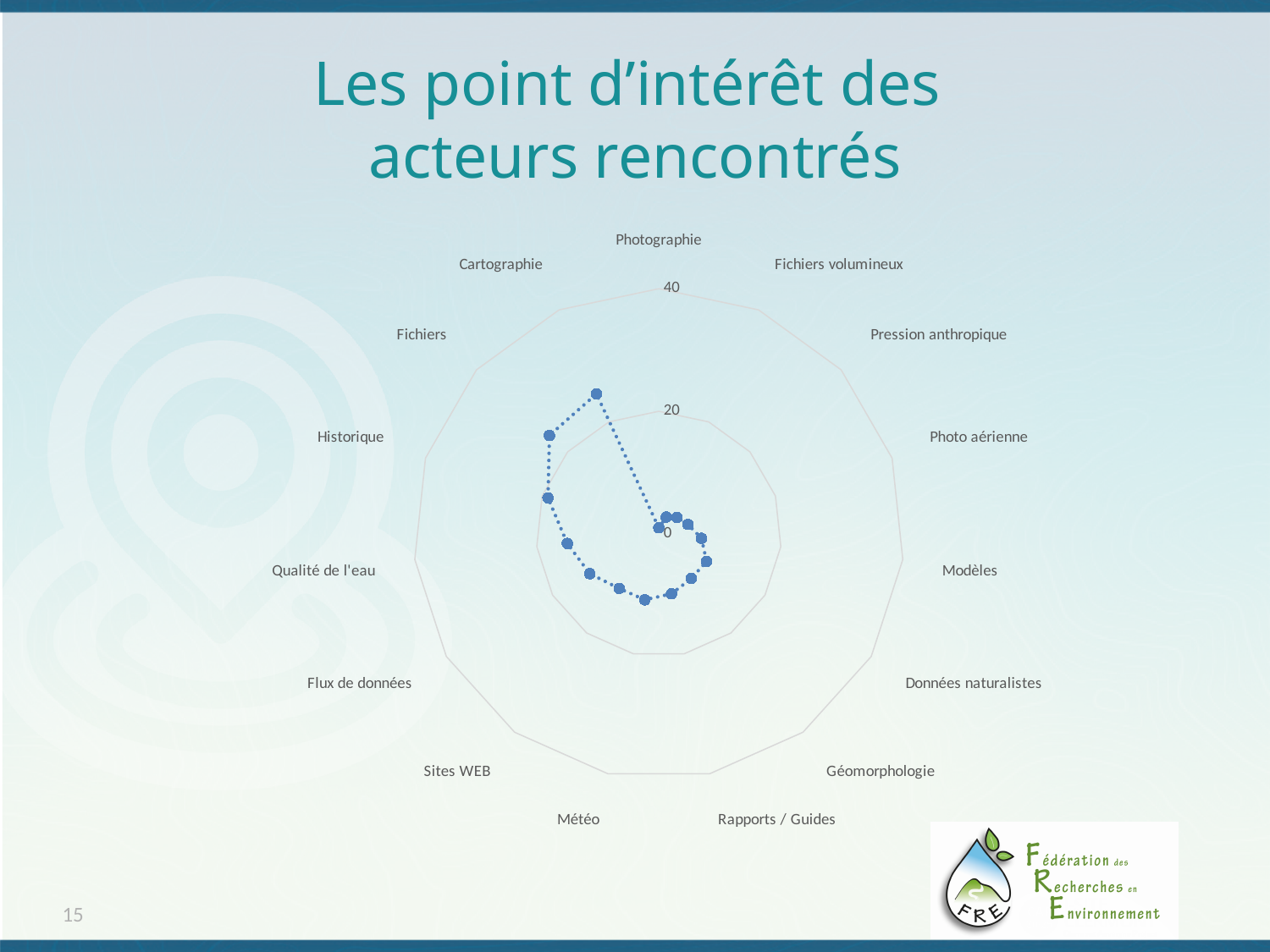
Is the value for Cartographie greater or less than 40? less Is the value for Cartographie greater or less than 20? greater What kind of chart is shown on the slide? Radar chart How many categories are plotted on the radar chart? 15 Is the value for Modèles greater or less than 20? less Which has the larger value, Historique or Géomorphologie? Historique Which has the larger value, Fichiers or Photo aérienne? Fichiers What is the title of the slide containing the radar chart? Les point d'intérêt des acteurs rencontrés Which has the larger value, Cartographie or Modèles? Cartographie